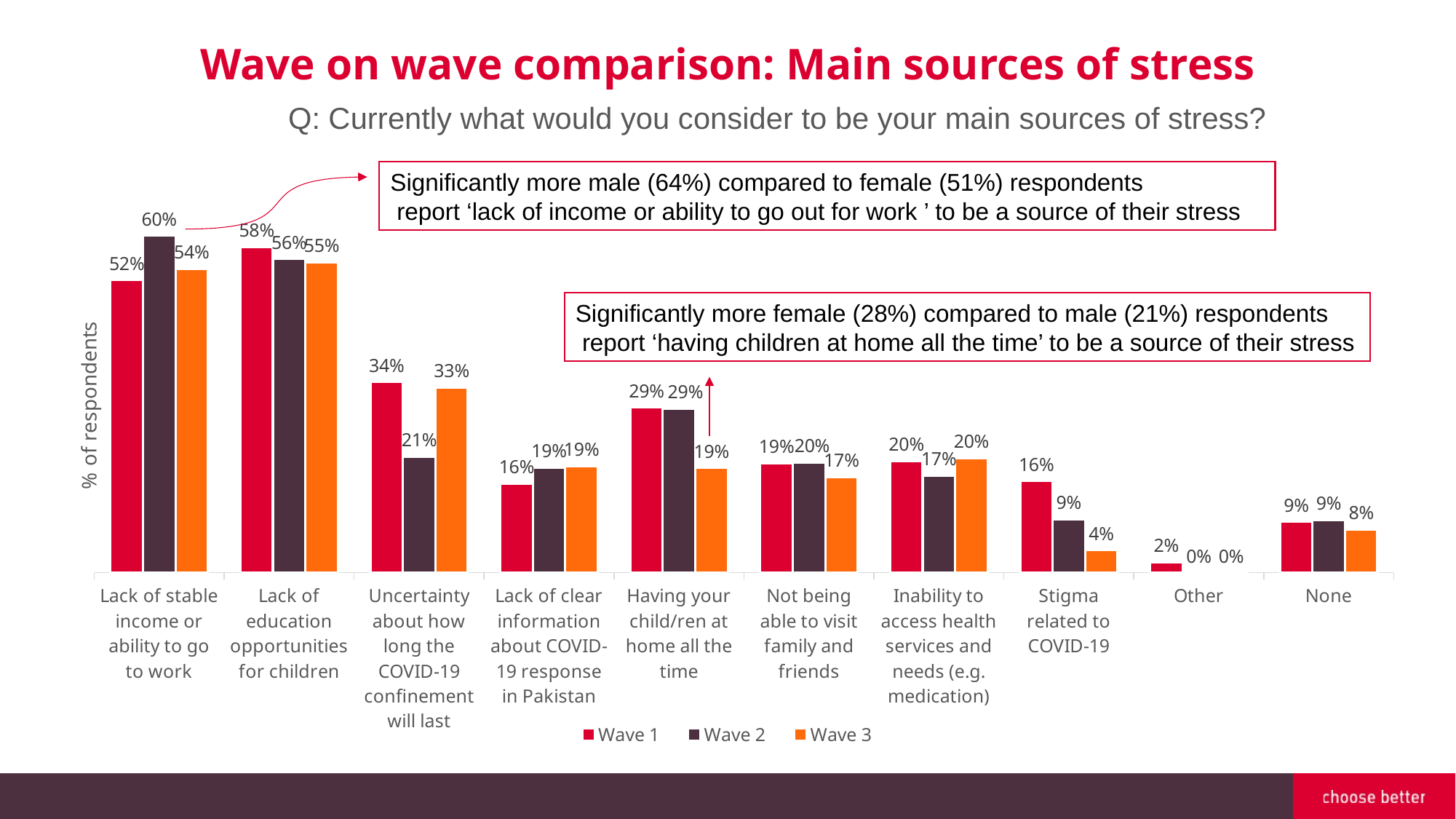
What is the difference between the Wave 1 and Wave 2 values for 'Stigma related to COVID-19'? 7% How many series does the legend list? 3 What is the Wave 3 value for 'Uncertainty about how long the COVID-19 confinement will last'? 33% What is the Wave 1 value for 'Stigma related to COVID-19'? 16% What is the y-axis label of the chart? % of respondents How many categories are shown on the x axis? 10 What kind of chart is shown on the slide? Bar chart Which is larger for 'Uncertainty about how long the COVID-19 confinement will last': the Wave 1 value or the Wave 2 value? Wave 1 What is the Wave 2 value for 'Lack of stable income or ability to go to work'? 60% Which category has the lowest Wave 3 value? Other Which category has the highest Wave 1 value? Lack of education opportunities for children What is the difference between the Wave 1 and Wave 3 values for 'Having your child/ren at home all the time'? 10%